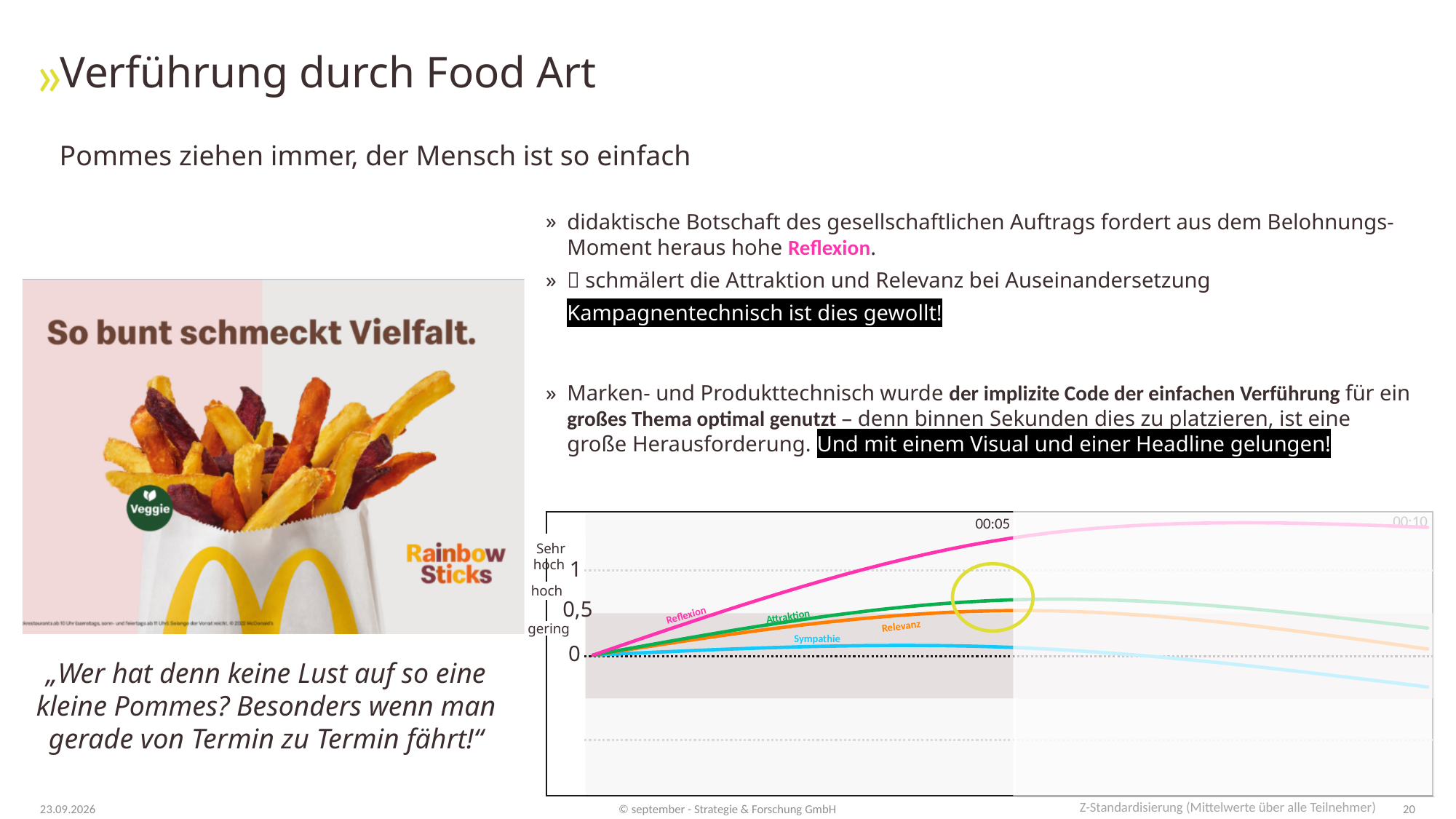
Is the value for Sympathie at 00:05 greater or less than 0,5? less How many labelled series (lines) does the chart show? 4 Which series has the highest value at the 00:05 mark? Reflexion Which series has the lowest value at the 00:05 mark? Sympathie Does the Sympathie line rise or fall between 00:05 and 00:10? fall Does the Reflexion line rise or fall between the start and the 00:05 mark? rise At 00:05, which is larger: Reflexion or Sympathie? Reflexion What kind of chart is shown at the bottom right of the slide? line chart Is the value for Reflexion at 00:05 greater or less than 1? greater What colour is the Reflexion line in the chart? pink At 00:05, which is larger: Attraktion or Sympathie? Attraktion Which two time marks are labelled along the top of the chart? 00:05 and 00:10